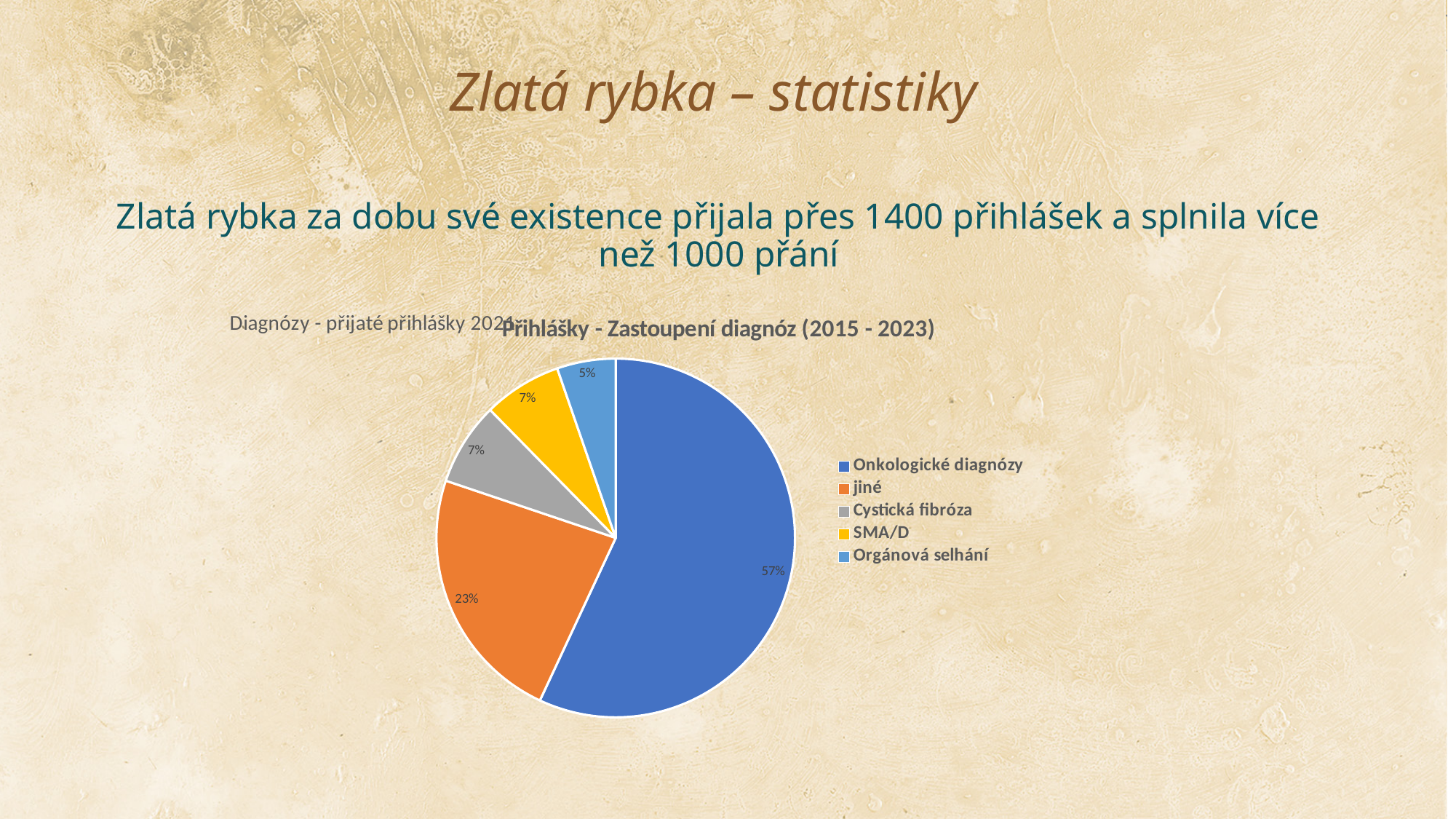
What percentage is shown for Cystická fibróza? 7% What is the title of the pie chart? Přihlášky - Zastoupení diagnóz (2015 - 2023) How many categories does the pie chart show? 5 Which category has the smallest slice of the pie? Orgánová selhání What is the difference in percentage points between Onkologické diagnózy and jiné? 34 What type of chart is shown on the slide? Pie chart What colour is the SMA/D slice in the pie chart? Yellow What percentage is shown for Orgánová selhání? 5% What percentage is shown for the jiné slice? 23% What share of the pie does Onkologické diagnózy represent? 57% Which is larger, the share for jiné or the share for SMA/D? jiné Which category has the largest slice of the pie? Onkologické diagnózy